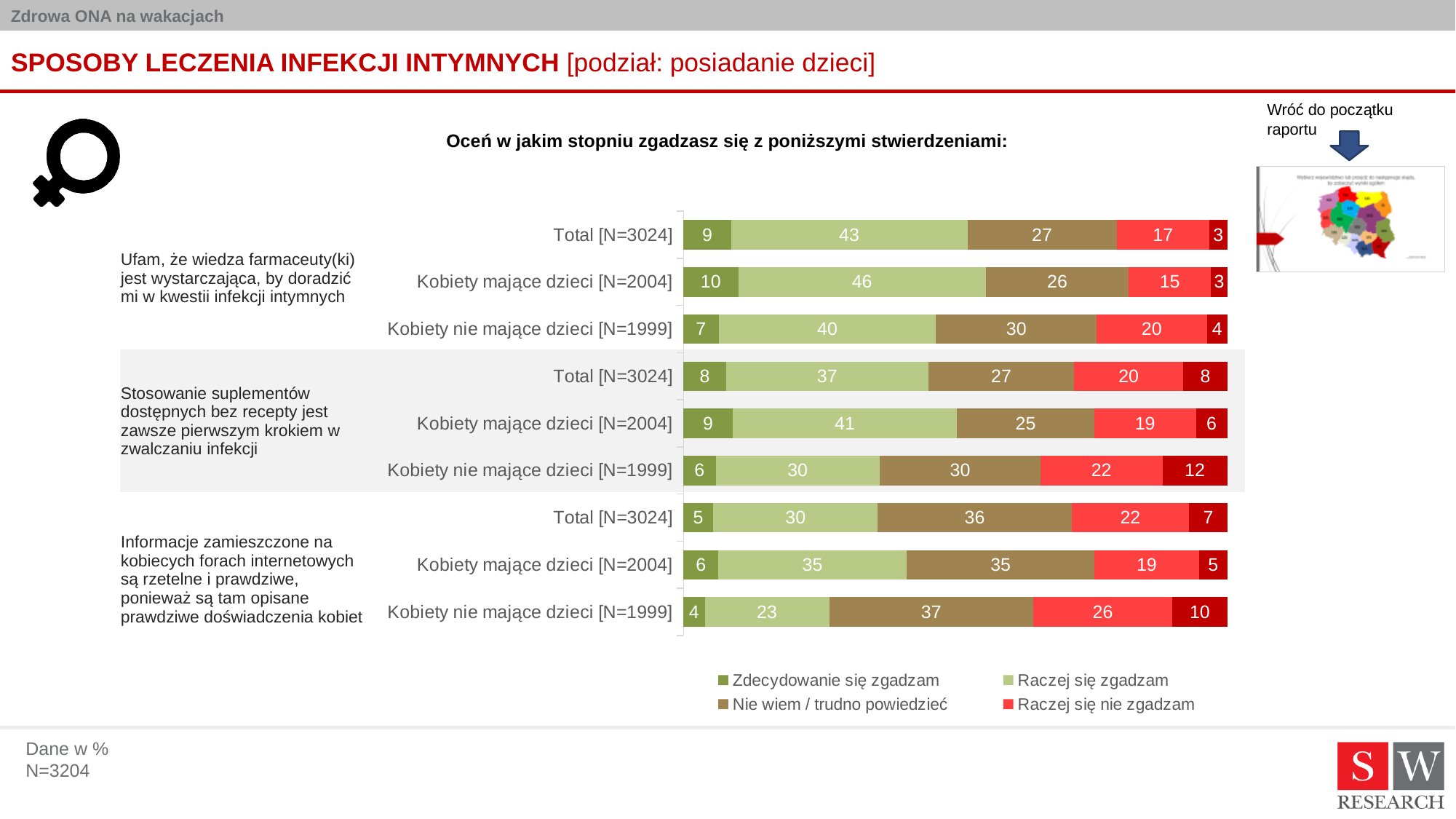
What question is shown as the chart's title above the bars? Oceń w jakim stopniu zgadzasz się z poniższymi stwierdzeniami: For the statement 'Ufam, że wiedza farmaceuty(ki)...', is the 'Raczej się nie zgadzam' value larger for Kobiety mające dzieci [N=2004] or Kobiety nie mające dzieci [N=1999]? Kobiety nie mające dzieci [N=1999] For the statement 'Stosowanie suplementów dostępnych bez recepty...', what is the difference between the 'Raczej się zgadzam' values for Kobiety mające dzieci [N=2004] and Kobiety nie mające dzieci [N=1999]? 11 For the statement 'Stosowanie suplementów dostępnych bez recepty...', what is the 'Nie wiem / trudno powiedzieć' value for Kobiety nie mające dzieci [N=1999]? 30 For the statement 'Informacje zamieszczone na kobiecych forach internetowych...', what is the 'Raczej się nie zgadzam' value for Kobiety nie mające dzieci [N=1999]? 26 For the statement 'Ufam, że wiedza farmaceuty(ki)...', which group has the highest 'Raczej się zgadzam' value? Kobiety mające dzieci [N=2004] For the statement 'Ufam, że wiedza farmaceuty(ki) jest wystarczająca...', what is the 'Raczej się zgadzam' value for Total [N=3024]? 43 How many bars are plotted in the chart? 9 What kind of chart is shown on the slide? stacked bar chart How many series does the legend list? 4 For the statement 'Informacje zamieszczone na kobiecych forach internetowych...', which group has the lowest 'Zdecydowanie się zgadzam' value? Kobiety nie mające dzieci [N=1999] For the statement 'Informacje zamieszczone na kobiecych forach internetowych...', what is the combined 'Zdecydowanie się zgadzam' and 'Raczej się zgadzam' value for Total [N=3024]? 35